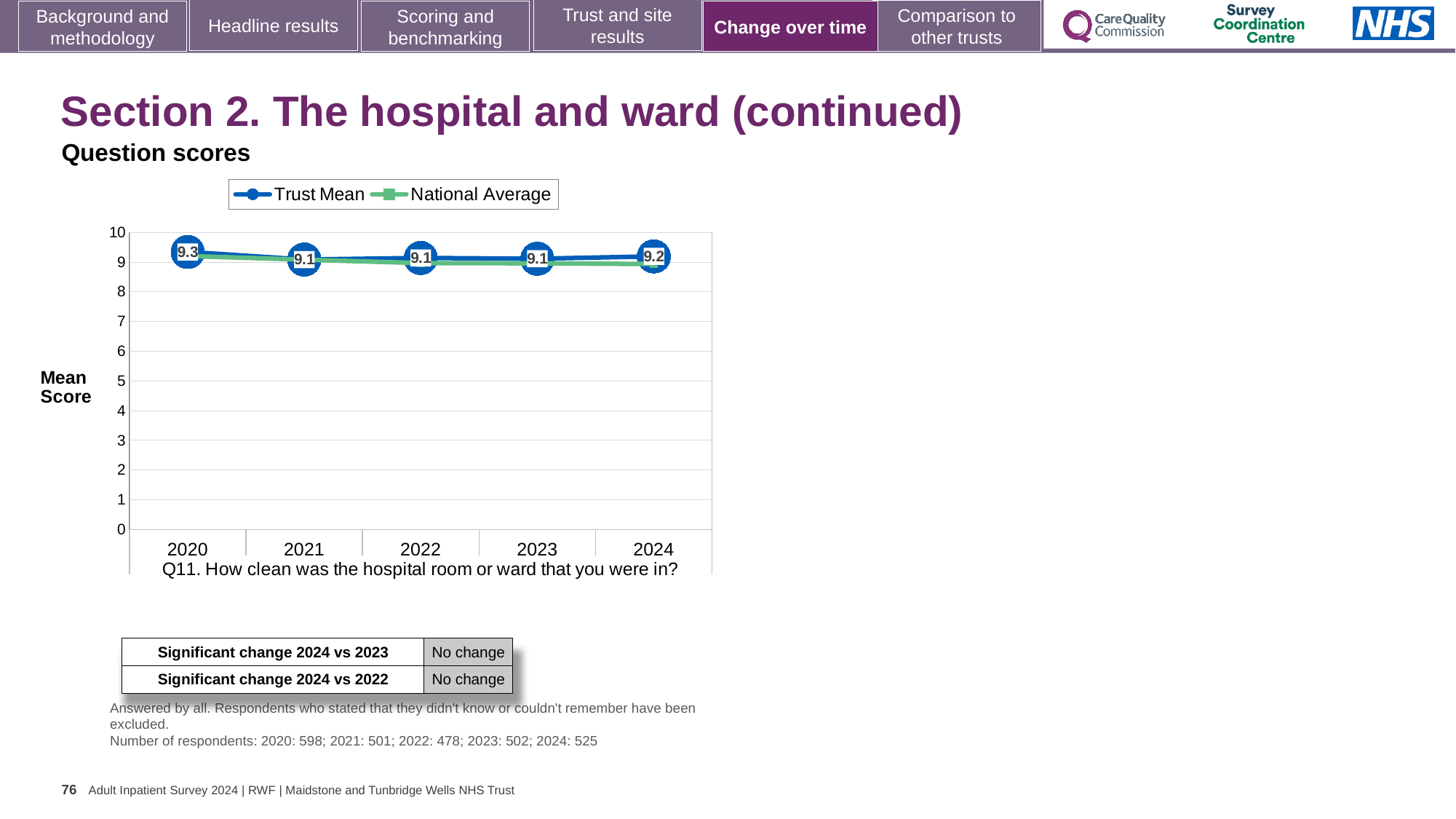
What is the label on the y axis of the Q11 chart? Mean Score In which year is the Trust Mean score highest on the Q11 chart? 2020 Does the Trust Mean score rise or fall from 2020 to 2021? Fall What is the Trust Mean score for 2022 on the Q11 chart? 9.1 How many series does the legend of the Q11 chart list? 2 What is the Trust Mean score for 2024 on the Q11 chart? 9.2 Which is larger, the Trust Mean score for 2020 or for 2021? 2020 Is the National Average value for 2024 greater or less than 8? greater What is the Trust Mean score for 2020 on the Q11 chart? 9.3 How many years are shown on the x axis of the Q11 chart? 5 What kind of chart is used to show the Q11 question scores? Line chart What is the difference between the Trust Mean score in 2020 and in 2024? 0.1